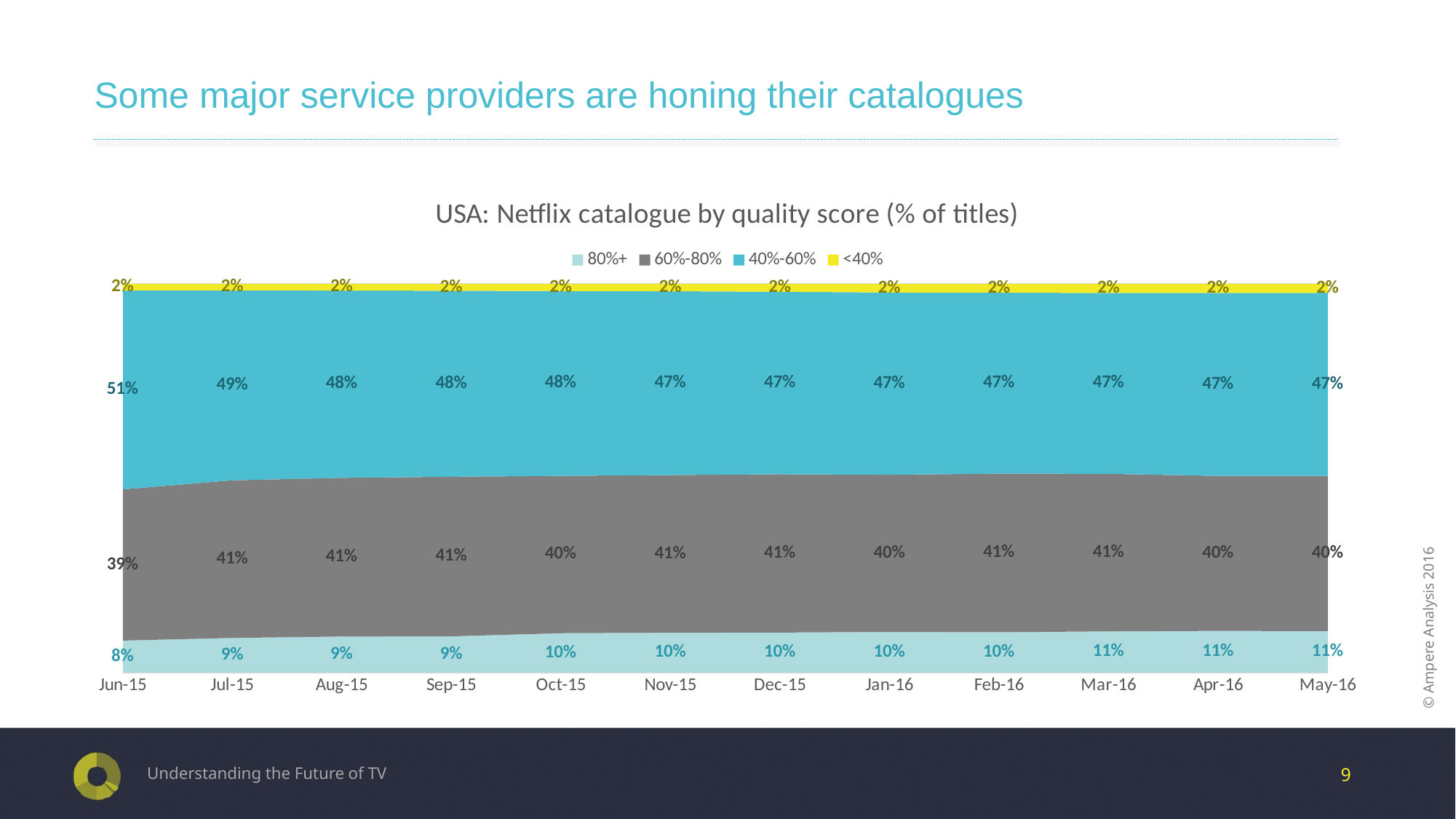
In which month is the 40%-60% series highest? Jun-15 Does the 80%+ series rise or fall from Jun-15 to May-16? Rise What is the difference between the 40%-60% value in Jun-15 and in May-16? 4% What is the value for the <40% series in Dec-15? 2% What is the value for the 80%+ series in May-16? 11% What is the value for the 60%-80% series in Jun-15? 39% How many series does the legend list? 4 What is the chart's title? USA: Netflix catalogue by quality score (% of titles) What kind of chart is shown on the slide? Stacked area chart What is the value for the 40%-60% series in Jun-15? 51% In which month is the 80%+ series lowest? Jun-15 How many months are shown along the x axis? 12